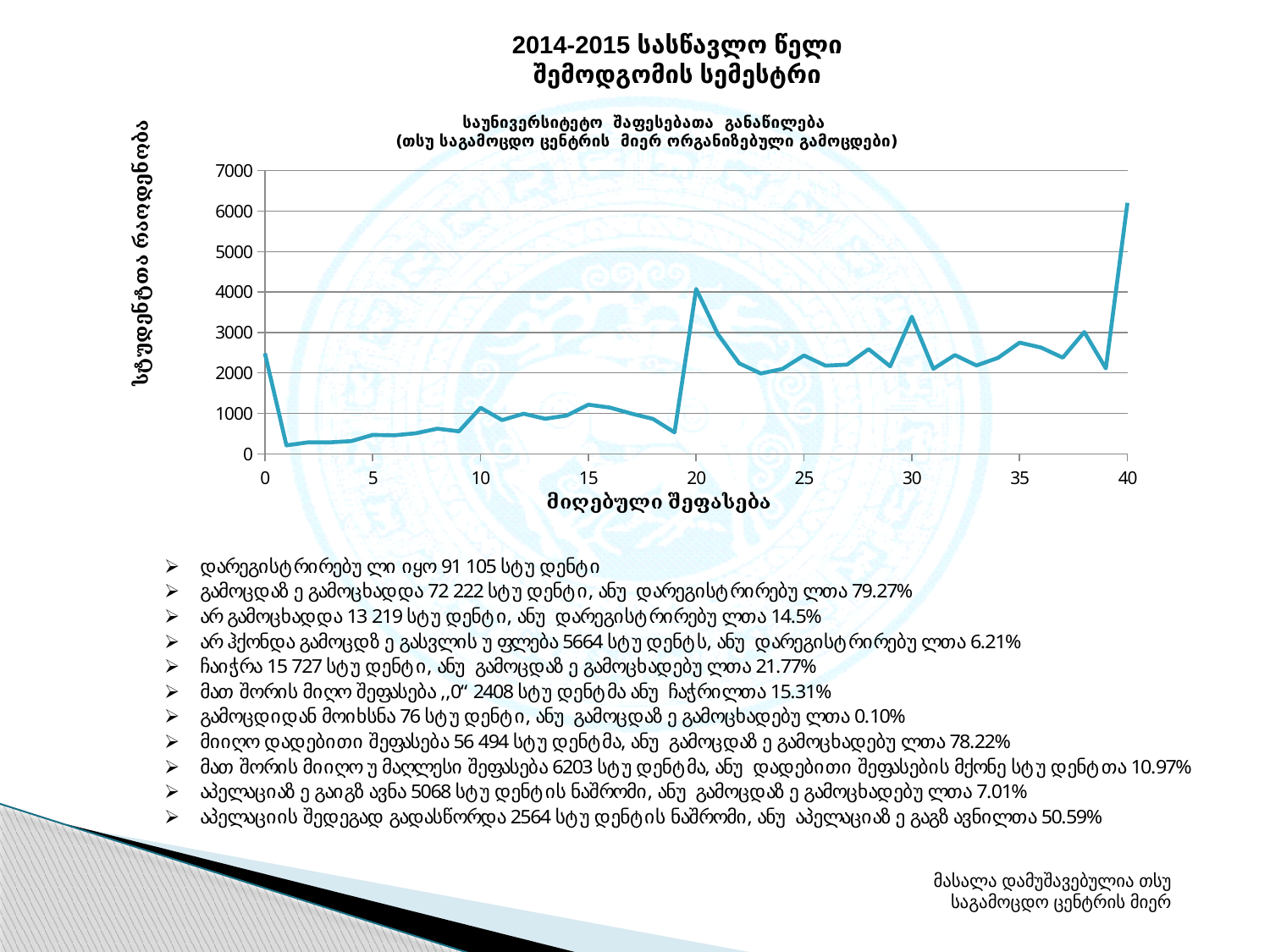
Which has the larger value: score 20 or score 30? score 20 Is the value at score 35 greater or less than 3000? less What kind of chart is shown on the slide? line chart At which score on the x axis does the line reach its highest value? 40 Is the value at score 19 greater or less than 1000? less Is the value at score 1 greater or less than 1000? less At which score on the x axis does the line reach its lowest value? 1 Does the line rise or fall between score 0 and score 1? fall Which has the larger value: score 0 or score 1? score 0 What is the highest tick value shown on the y axis? 7000